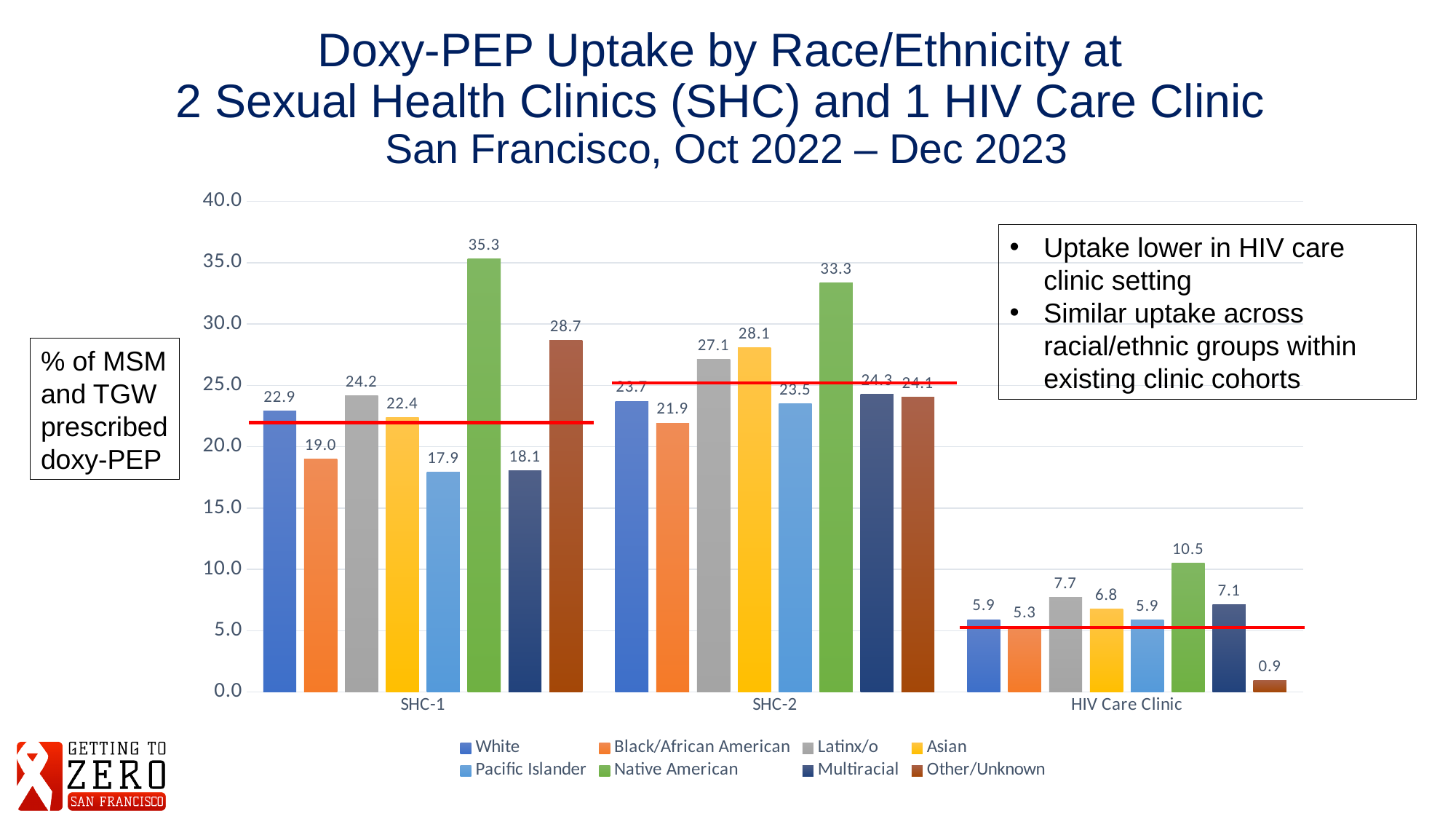
What is the value for Other/Unknown at the HIV Care Clinic? 0.9 Which racial/ethnic group has the lowest value at the HIV Care Clinic? Other/Unknown How many clinic categories are shown on the x axis? 3 Is the value for Native American at the HIV Care Clinic greater or less than 10.0? greater What is the value for Asian at SHC-2? 28.1 How many series does the legend list? 8 What is the value for Native American at SHC-1? 35.3 What kind of chart is shown on the slide? Bar chart Which racial/ethnic group has the highest value at SHC-2? Native American What is the value for Pacific Islander at SHC-1? 17.9 Which is larger at SHC-2: the Latinx/o value or the Black/African American value? Latinx/o What is the difference between the Native American and Black/African American values at SHC-1? 16.3